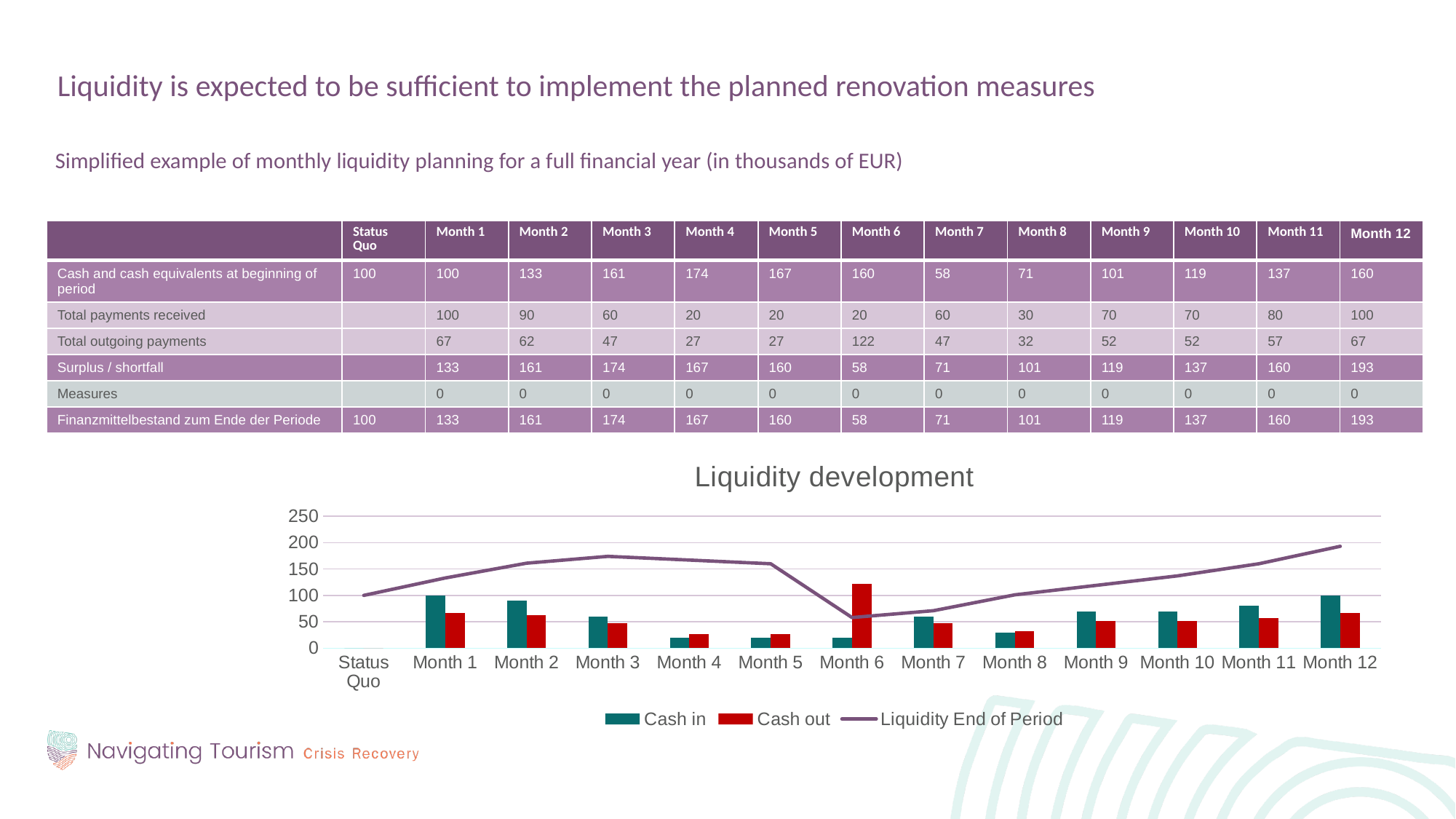
In the "Liquidity development" chart, which is larger in Month 6: Cash in or Cash out? Cash out How many categories are shown on the x axis of the "Liquidity development" chart? 13 In the "Liquidity development" chart, what is the difference between Cash in and Cash out in Month 1? 33 In the "Liquidity development" chart, is the Cash in value for Month 4 greater or less than 50? less How many series does the legend of the "Liquidity development" chart list? 3 In the "Liquidity development" chart, does the Liquidity End of Period line rise or fall from Month 6 to Month 12? Rises In the "Liquidity development" chart, which month has the highest Cash out bar? Month 6 In the "Liquidity development" chart, what is the Liquidity End of Period value at Status Quo? 100 In the "Liquidity development" chart, is the Liquidity End of Period value for Month 12 greater or less than 150? greater What kind of chart is the "Liquidity development" chart? A bar chart combined with a line In the "Liquidity development" chart, what is the Cash in value for Month 1? 100 In the "Liquidity development" chart, at which month is the Liquidity End of Period line lowest? Month 6